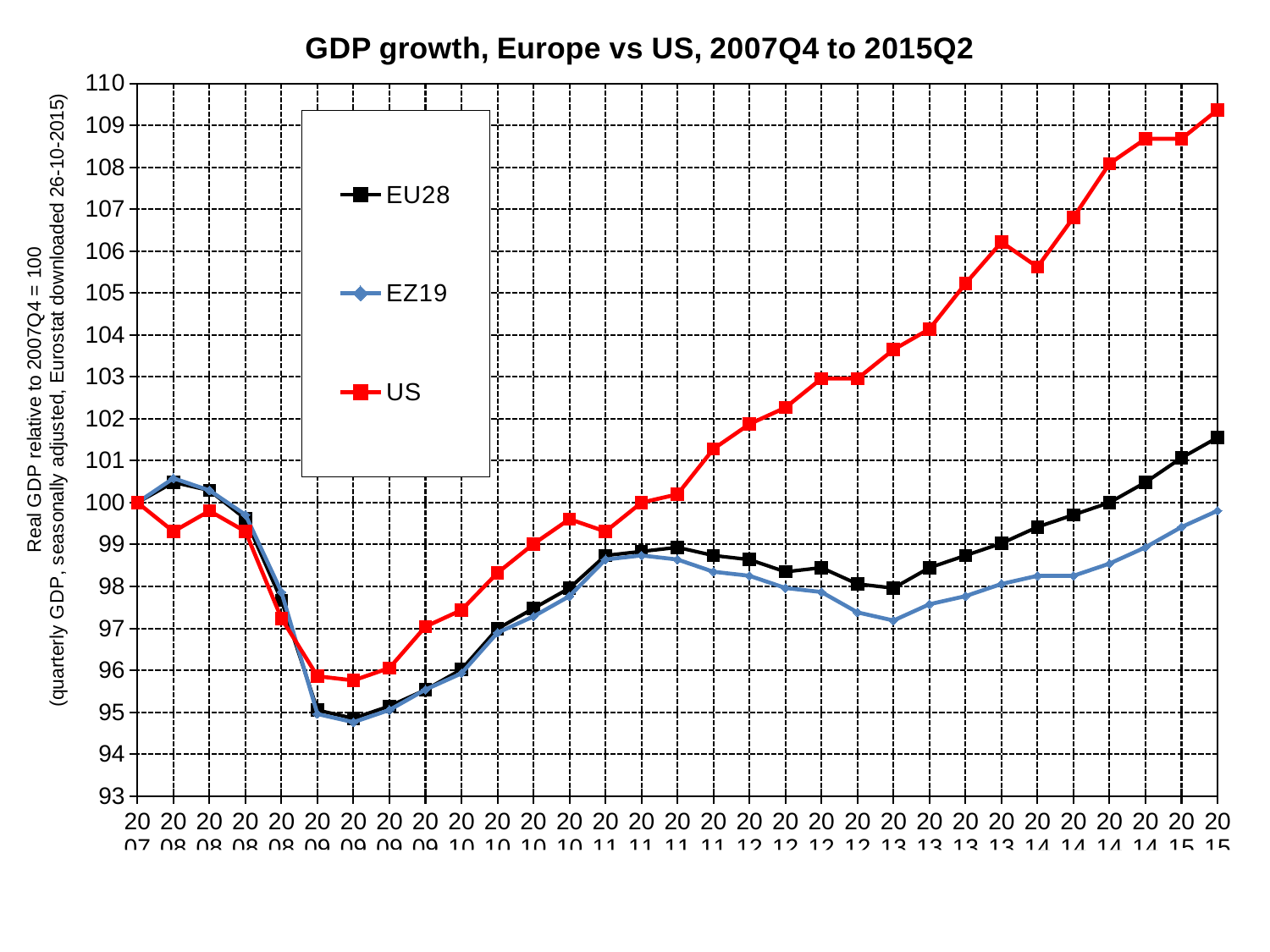
Which series has the highest value at the last point on the chart? US Does the US series rise or fall from 2010 to the end of the chart? rise What is the title of the chart? GDP growth, Europe vs US, 2007Q4 to 2015Q2 What is the value of all three series at the first point (2007Q4)? 100 Which series is plotted in red? US Which series has the lowest value at the last point on the chart? EZ19 How many series does the legend list? 3 Is the final value for the US series greater or less than 108? greater Is the lowest value reached by the EU28 series greater or less than 96? less What kind of chart is shown on the slide? line chart Is the final value for the EZ19 series greater or less than 100? less At the last point on the chart, which is larger, the US value or the EU28 value? US